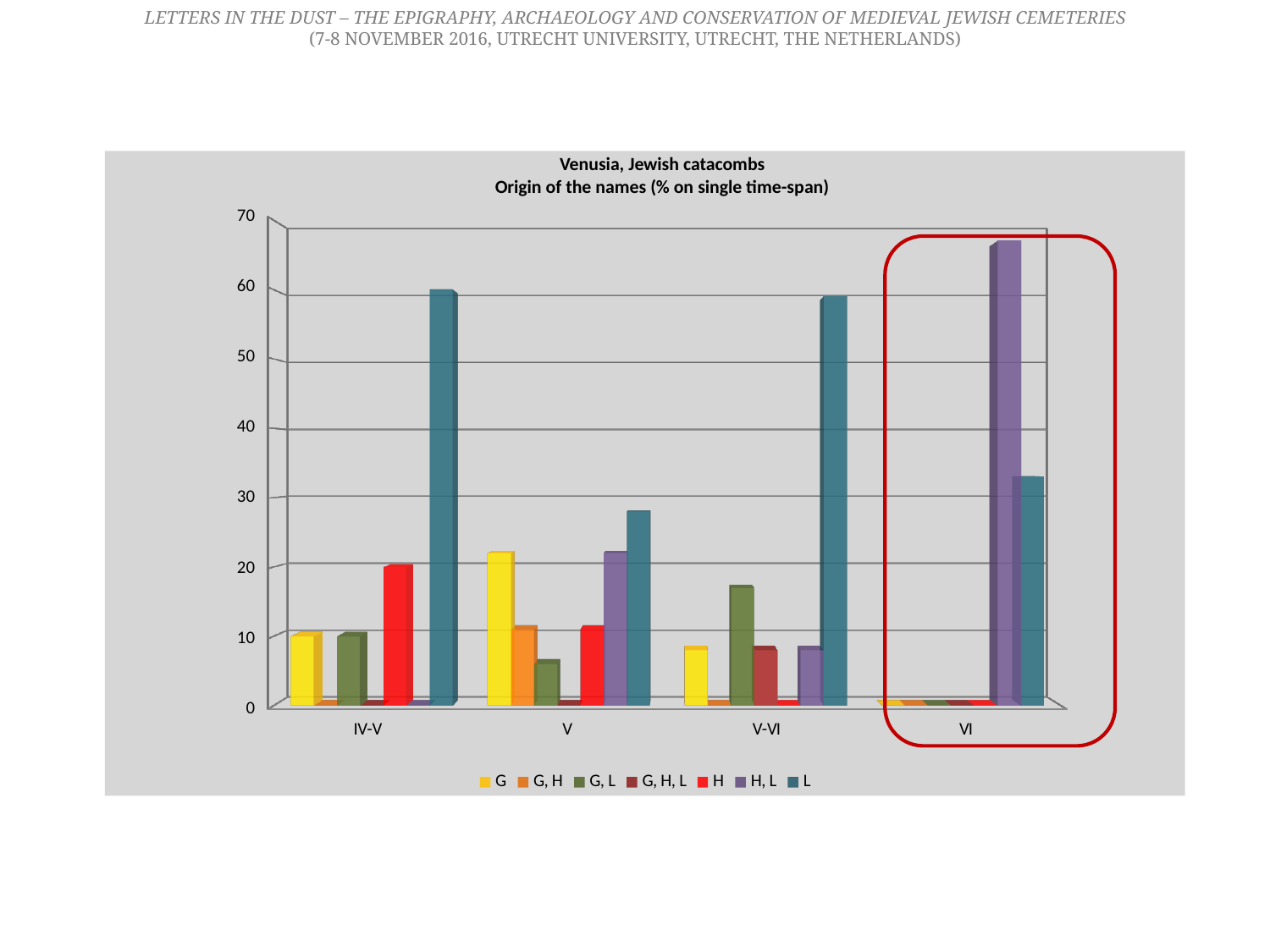
Is the value for H, L in the VI time-span greater or less than 60? greater How many series does the legend list? 7 Which series has the tallest bar in the IV-V time-span? L Is the value for H in the IV-V time-span greater or less than 30? less In which time-span is the H, L bar the highest? VI How many time-span categories are shown on the x axis? 4 Is the value for L in the IV-V time-span greater or less than 50? greater Which time-span category is highlighted with a red outline on the chart? VI What kind of chart is shown on the slide? bar chart Which series has the tallest bar in the VI time-span? H, L In the V time-span, which is larger, the value for L or the value for G? L